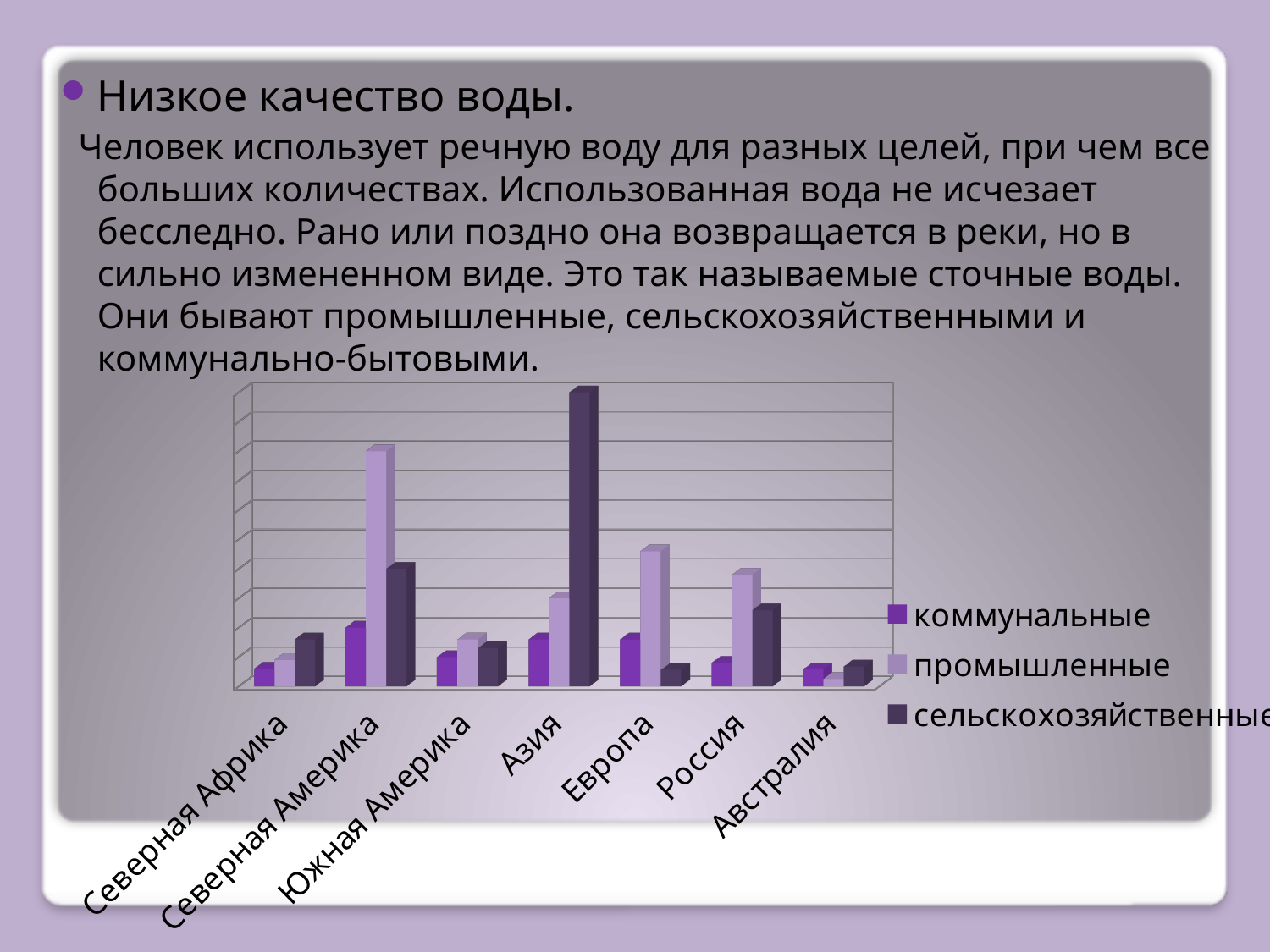
Which series is shown in the lightest colour in the legend? промышленные For Европа, which is larger: промышленные or сельскохозяйственные? промышленные Which is larger: the сельскохозяйственные value for Азия or for Европа? Азия How many series does the chart legend list? 3 How many categories are shown on the x axis of the chart? 7 Which category has the highest value for the сельскохозяйственные series? Азия Which series has the tallest bar for Азия? сельскохозяйственные Which category has the lowest value for the промышленные series? Австралия Which category has the highest value for the промышленные series? Северная Америка What kind of chart is shown on the slide? bar chart Which category contains the tallest bar in the whole chart? Азия